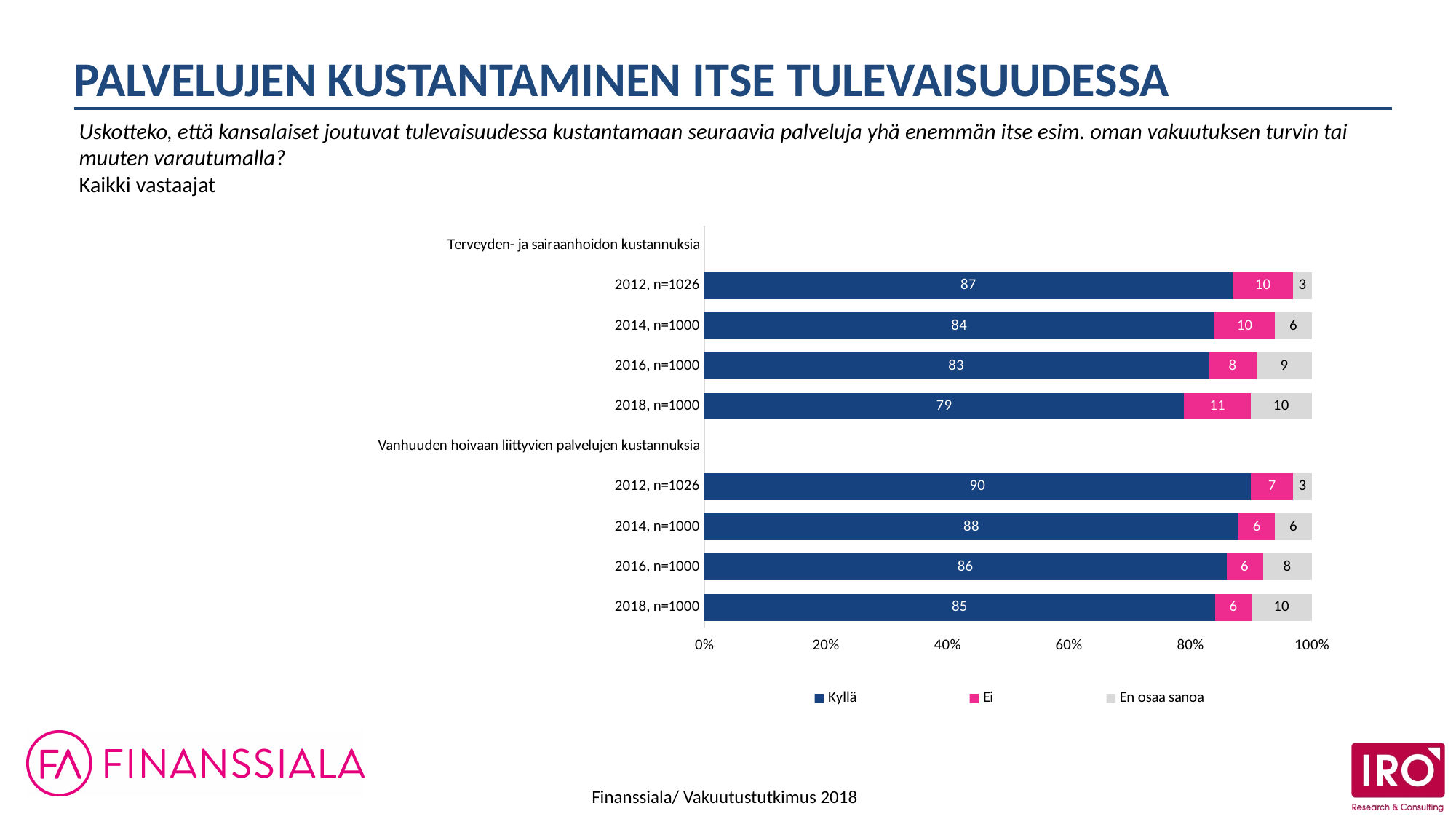
What is the Ei value for 2012, n=1026 under Vanhuuden hoivaan liittyvien palvelujen kustannuksia? 7 What is the difference between the Kyllä values for 2012, n=1026 and 2018, n=1000 under Terveyden- ja sairaanhoidon kustannuksia? 8 Which bar has the highest Kyllä value? Vanhuuden hoivaan liittyvien palvelujen kustannuksia, 2012, n=1026 What is the Kyllä value for 2018, n=1000 under Terveyden- ja sairaanhoidon kustannuksia? 79 What is the En osaa sanoa value for 2016, n=1000 under Terveyden- ja sairaanhoidon kustannuksia? 9 What kind of chart is shown on the slide? Stacked bar chart How many series does the legend list? 3 Which bar has the lowest Kyllä value? Terveyden- ja sairaanhoidon kustannuksia, 2018, n=1000 Do the Kyllä values rise or fall from 2012 to 2018 under Vanhuuden hoivaan liittyvien palvelujen kustannuksia? Fall How many bars are plotted in the chart? 8 What is the total of the 2014, n=1000 bar under Vanhuuden hoivaan liittyvien palvelujen kustannuksia? 100 Which is larger: the Ei value for 2018, n=1000 under Terveyden- ja sairaanhoidon kustannuksia or the Ei value for 2018, n=1000 under Vanhuuden hoivaan liittyvien palvelujen kustannuksia? Terveyden- ja sairaanhoidon kustannuksia, 2018, n=1000